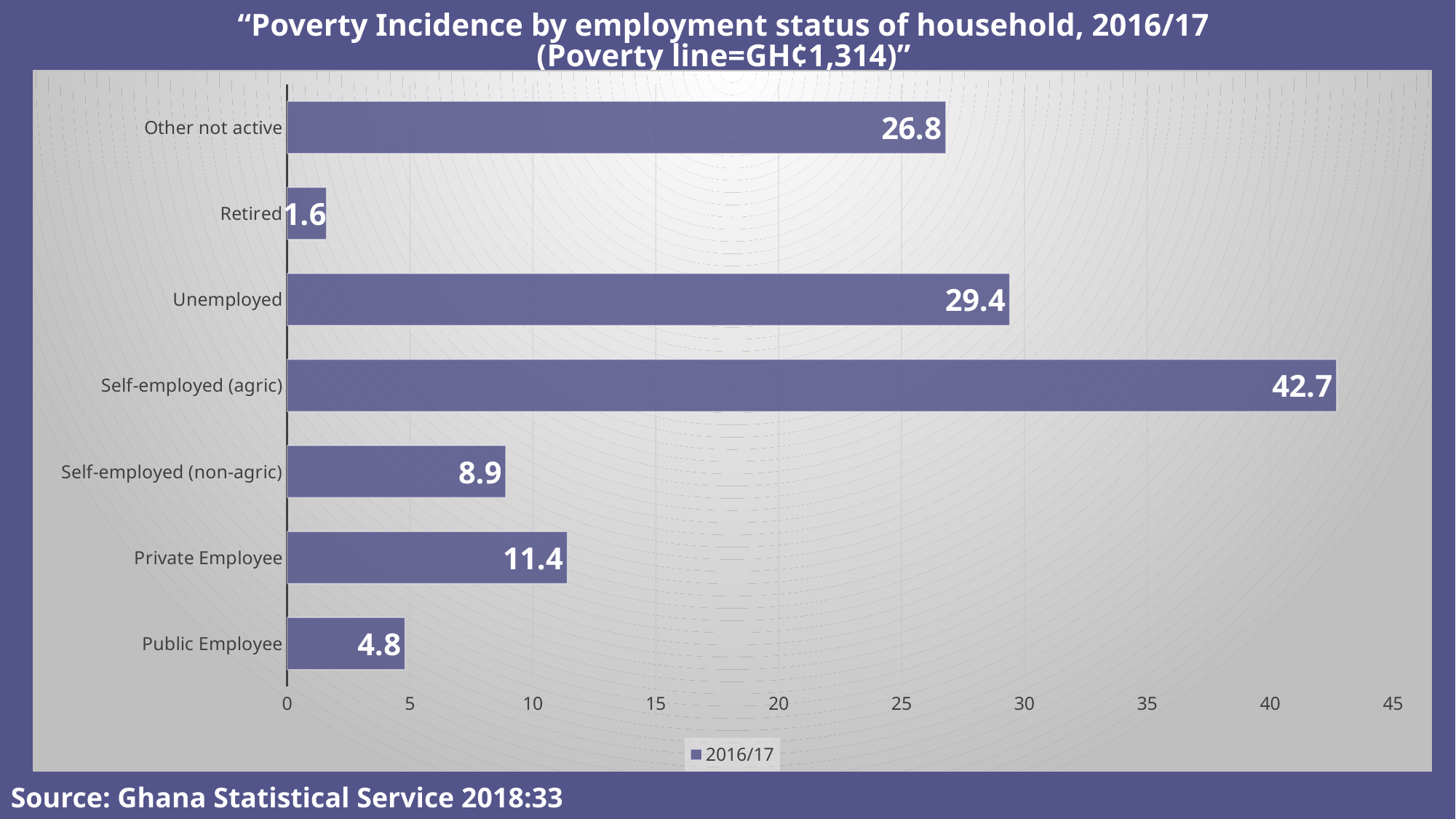
Which employment status has the highest poverty incidence? Self-employed (agric) What kind of chart is shown on the slide? Bar chart What series name is shown in the legend? 2016/17 What is the difference between the values for Unemployed and Other not active? 2.6 What is the value shown for Private Employee? 11.4 Which employment status has the lowest poverty incidence? Retired Which is larger, the value for Self-employed (non-agric) or Public Employee? Self-employed (non-agric) How many employment status categories are shown in the chart? 7 What is the poverty incidence for Self-employed (agric)? 42.7 How many series does the legend list? 1 What is the difference between the values for Private Employee and Public Employee? 6.6 What is the poverty incidence for Retired households? 1.6